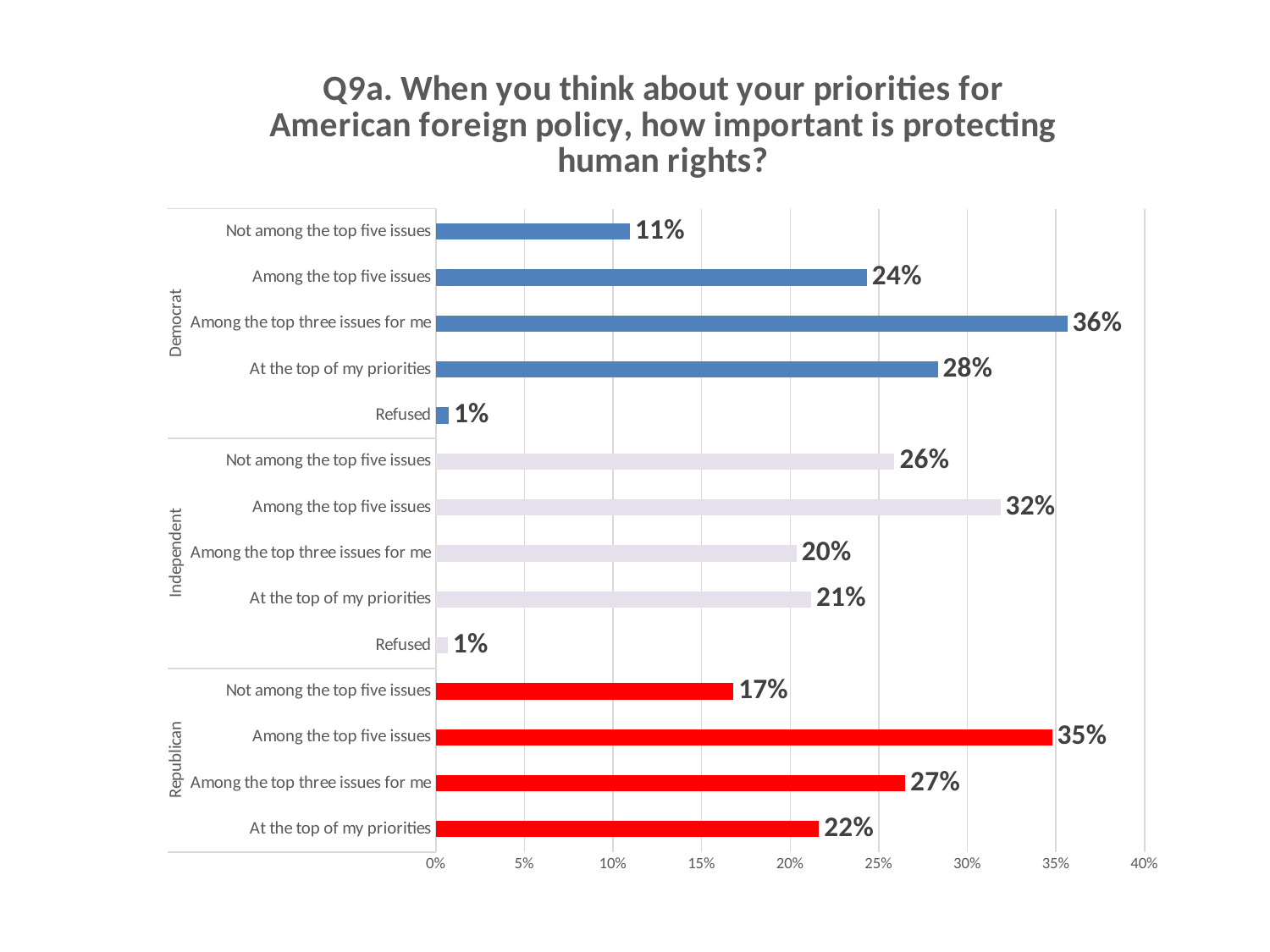
How many bars are plotted in the chart? 14 Is the Republican value for 'Among the top three issues for me' greater or less than 25%? greater What kind of chart is shown on the slide? Bar chart Which group has a larger percentage for 'Not among the top five issues', Democrats or Independents? Independents What percentage of Republicans said protecting human rights is among the top five issues? 35% Which response has the lowest percentage among Independents? Refused What is the difference between the Democrat and Republican percentages for 'At the top of my priorities'? 6% Which response has the highest percentage among Democrats? Among the top three issues for me What percentage of Independents said protecting human rights is not among the top five issues? 26% What percentage of Democrats said protecting human rights is among the top three issues for them? 36% What is the highest value shown on the x axis? 40% What colour are the bars for the Republican group? Red